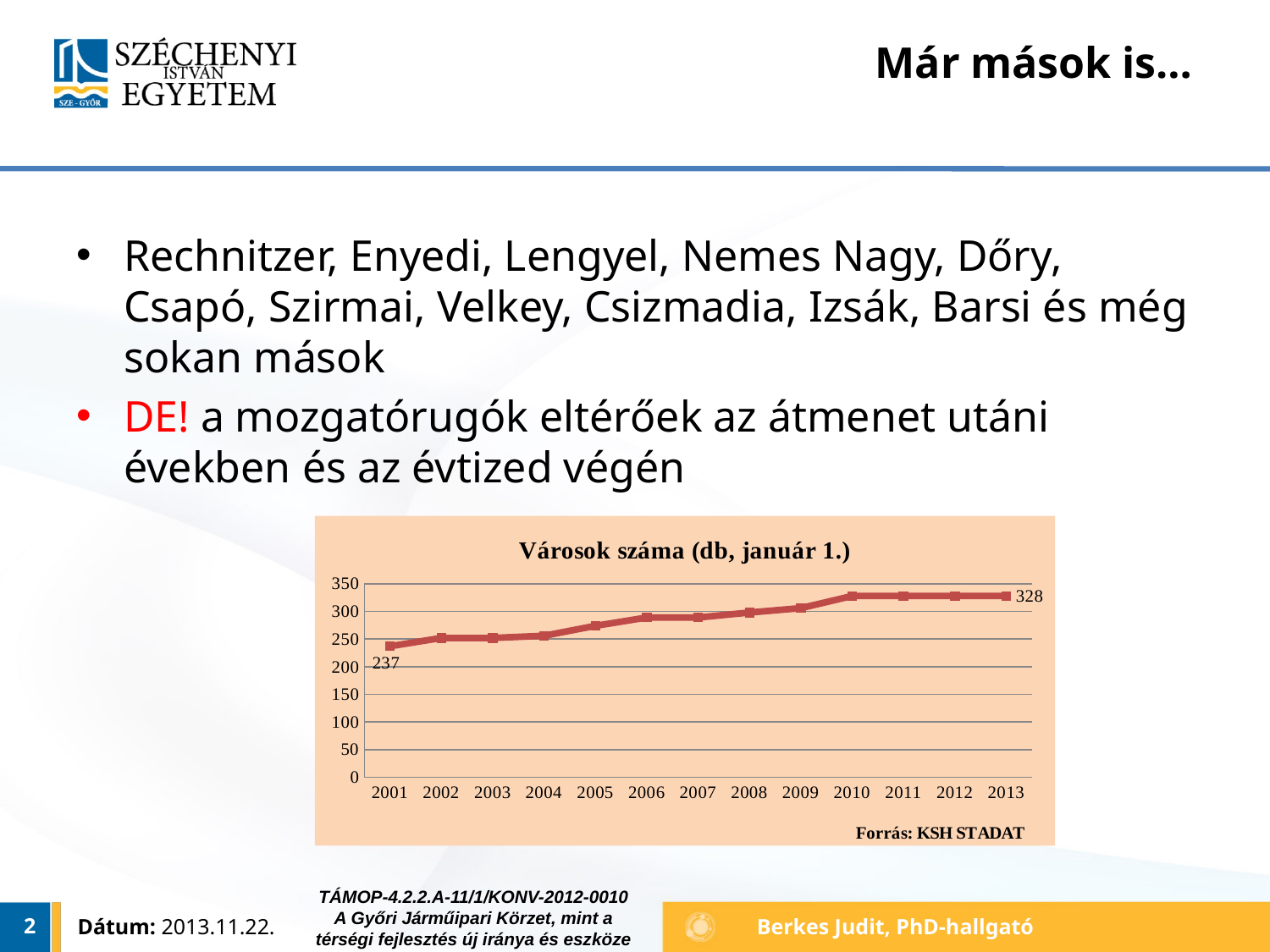
How many years are shown on the x axis of the chart? 13 What kind of chart is shown on the slide? line chart Which is larger, the value for 2001 or the value for 2013? 2013 Which year has the lowest value in the chart? 2001 What is the value for 2013 in the chart? 328 Do the values rise or fall from 2001 to 2013? rise Is the value for 2005 greater or less than 250? greater What is the difference between the values for 2013 and 2001? 91 Is the value for 2006 greater or less than 300? less Is the value for 2010 greater or less than 300? greater What is the value for 2001 in the chart? 237 What is the title of the chart? Városok száma (db, január 1.)